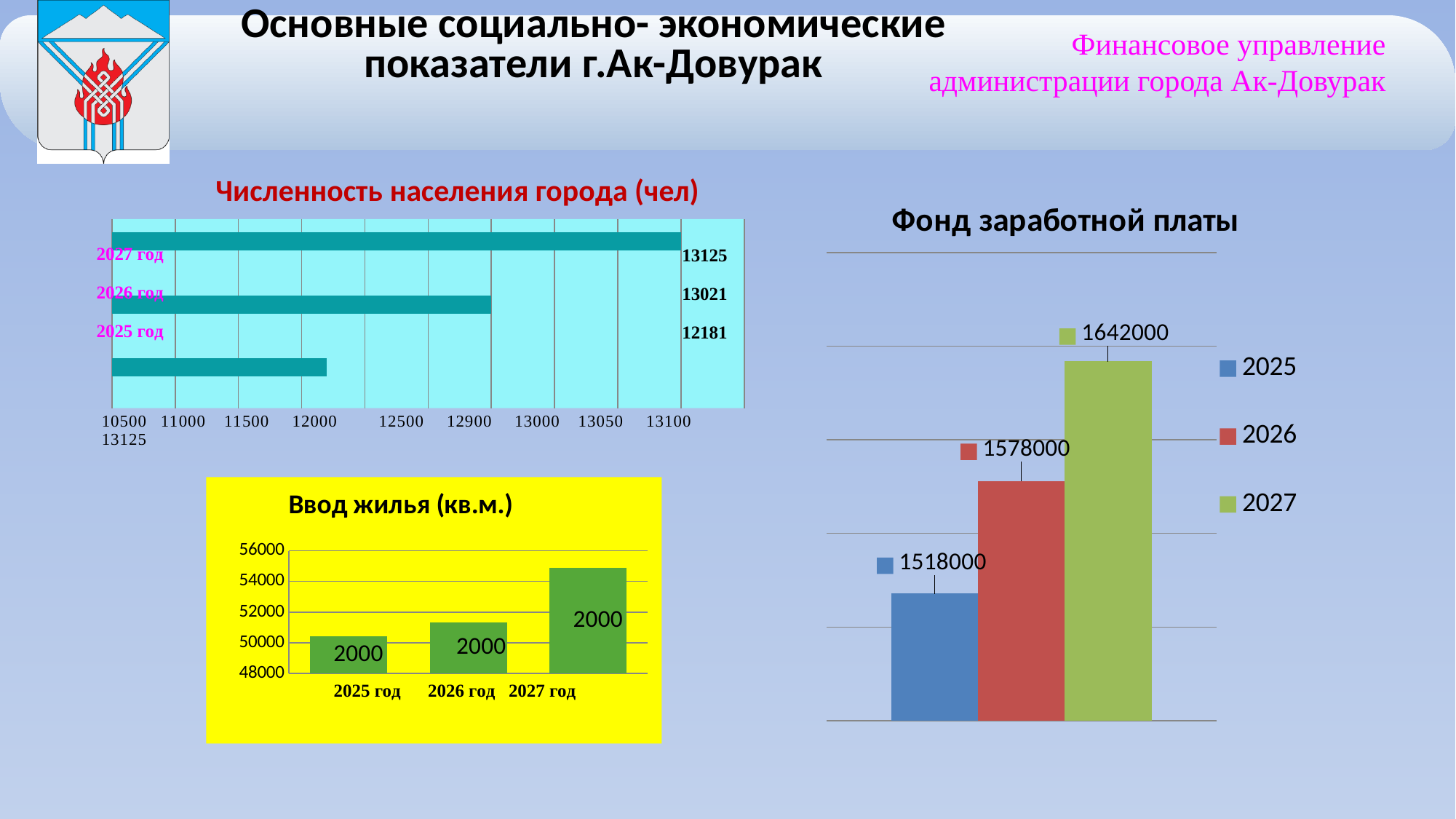
In the chart 'Численность населения города (чел)', which year has the lowest population? 2025 год In the chart 'Фонд заработной платы', what is the difference between the values for 2027 and 2025? 124000 In the chart 'Численность населения города (чел)', what is the value for 2027 год? 13125 In the chart 'Численность населения города (чел)', what is the difference between the values for 2027 год and 2025 год? 944 How many categories are shown in the chart 'Ввод жилья (кв.м.)'? 3 In the chart 'Фонд заработной платы', which year has the highest value? 2027 What kind of chart is 'Ввод жилья (кв.м.)'? bar chart In the chart 'Численность населения города (чел)', what is the value for 2025 год? 12181 How many series does the legend of the chart 'Фонд заработной платы' list? 3 In the chart 'Фонд заработной платы', what is the value for 2026? 1578000 In the chart 'Фонд заработной платы', which is larger, the value for 2025 or the value for 2026? 2026 In the chart 'Численность населения города (чел)', do the values rise or fall from 2025 to 2027? rise